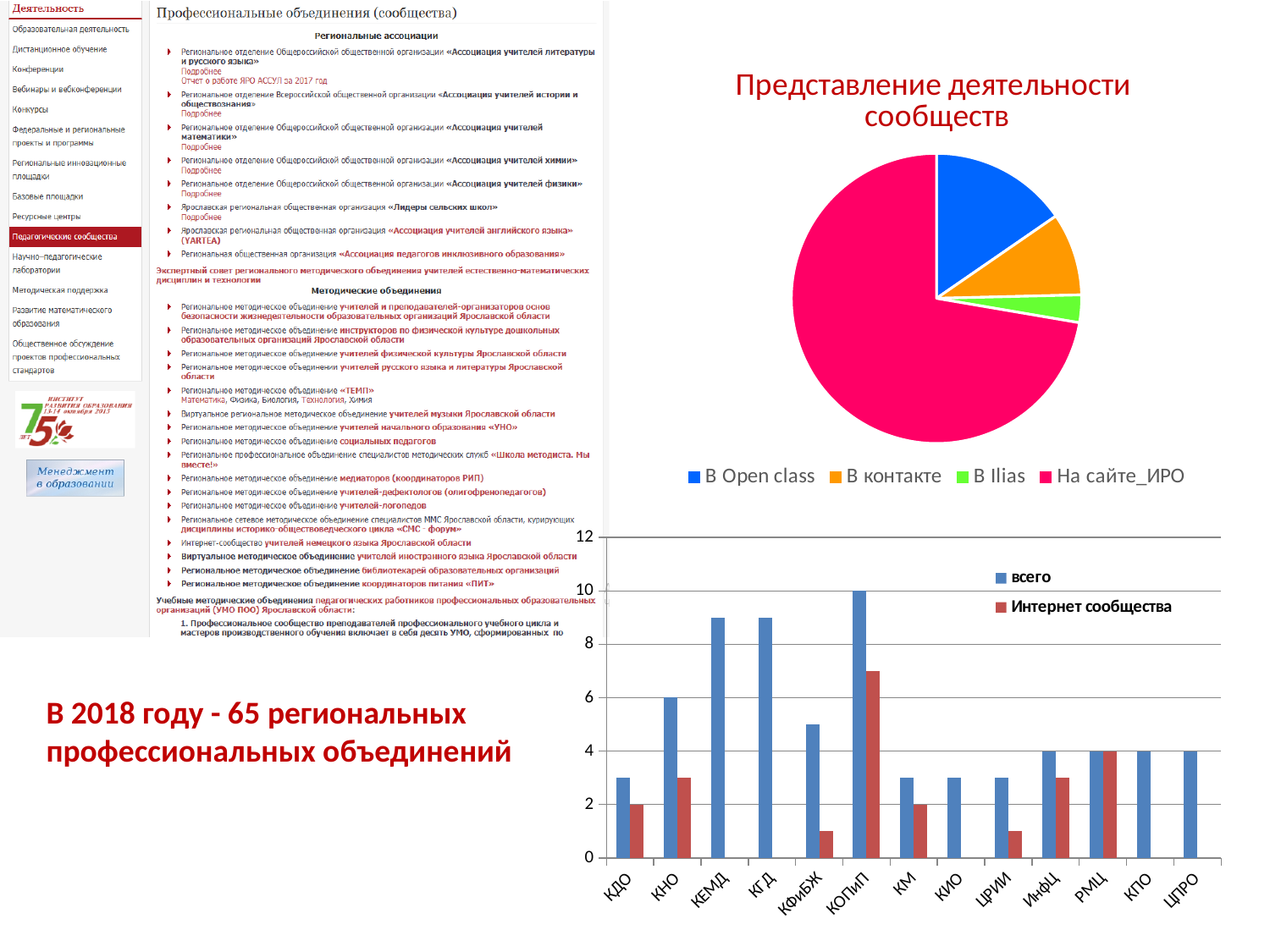
What kind of chart is the chart titled "Представление деятельности сообществ"? pie chart In the pie chart "Представление деятельности сообществ", which slice is the largest? На сайте_ИРО In the bar chart at the bottom right, which is larger: the "всего" value for КНО or for КДО? КНО In the bar chart at the bottom right, what is the value of "всего" for КОПиП? 10 How many entries does the legend of the pie chart "Представление деятельности сообществ" list? 4 In the bar chart at the bottom right, which category has the highest value for "всего"? КОПиП In the bar chart at the bottom right, is the value of "всего" for КЕМД greater or less than 8? greater In the bar chart at the bottom right, what is the value of "всего" for КНО? 6 What kind of chart is the chart at the bottom right of the slide? bar chart In the bar chart at the bottom right, how many categories are shown on the x axis? 13 In the pie chart "Представление деятельности сообществ", which slice is the smallest? В Ilias In the bar chart at the bottom right, how many series does the legend list? 2